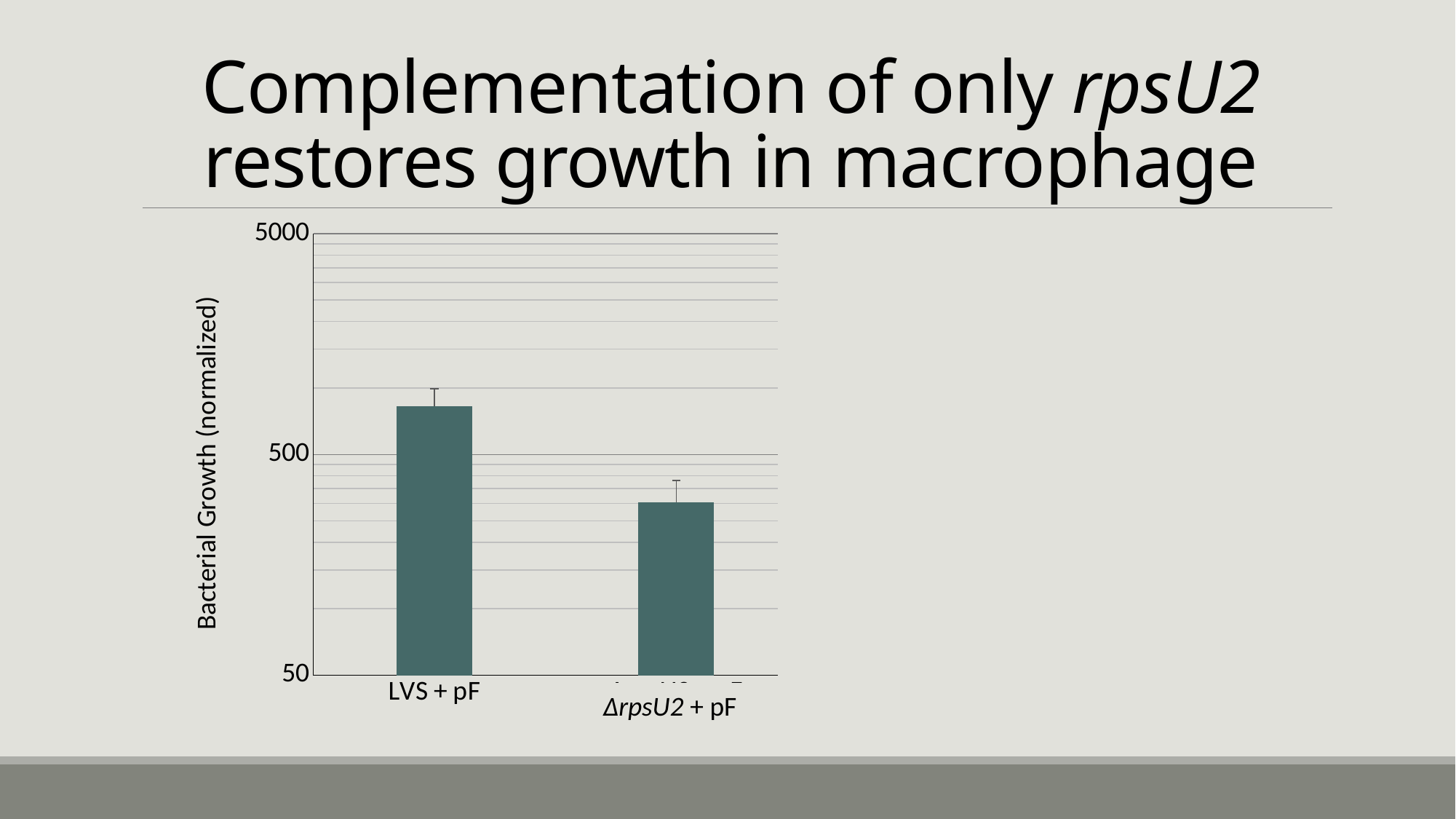
What kind of chart is shown on the slide? bar chart Which category has the highest bacterial growth? LVS + pF How many bars are plotted in the chart? 2 Do the bar values rise or fall from left to right along the x axis? fall What is the highest tick value shown on the y axis? 5000 Is the value for LVS + pF greater or less than 500? greater Is the value for ΔrpsU2 + pF greater or less than 50? greater Is the value for LVS + pF greater or less than 5000? less Which category has the lowest bacterial growth? ΔrpsU2 + pF What is the label of the y axis? Bacterial Growth (normalized) Which has the larger value, LVS + pF or ΔrpsU2 + pF? LVS + pF